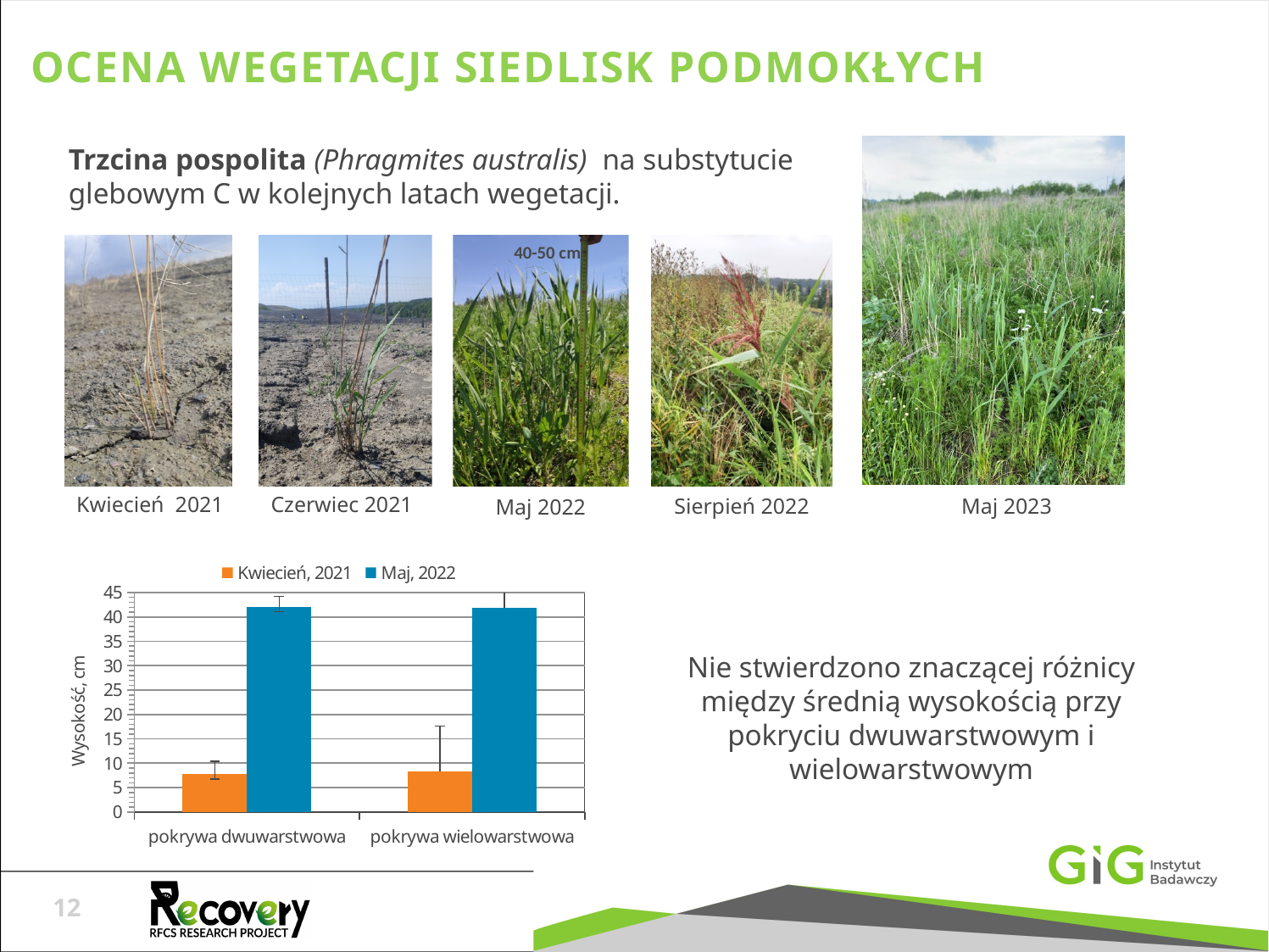
Which colour represents the Kwiecień, 2021 series in the chart? orange What is the label of the vertical axis of the chart? Wysokość, cm Is the value for Kwiecień, 2021 at pokrywa wielowarstwowa greater or less than 10? less What kind of chart is shown on the slide? bar chart Is the value for Maj, 2022 at pokrywa wielowarstwowa greater or less than 35? greater For pokrywa wielowarstwowa, which series has the smaller value: Kwiecień, 2021 or Maj, 2022? Kwiecień, 2021 What is the highest value shown on the vertical axis of the chart? 45 For pokrywa dwuwarstwowa, which series has the larger value: Kwiecień, 2021 or Maj, 2022? Maj, 2022 Is the value for Maj, 2022 at pokrywa dwuwarstwowa greater or less than 40? greater How many categories are shown on the x axis of the chart? 2 How many series does the chart's legend list? 2